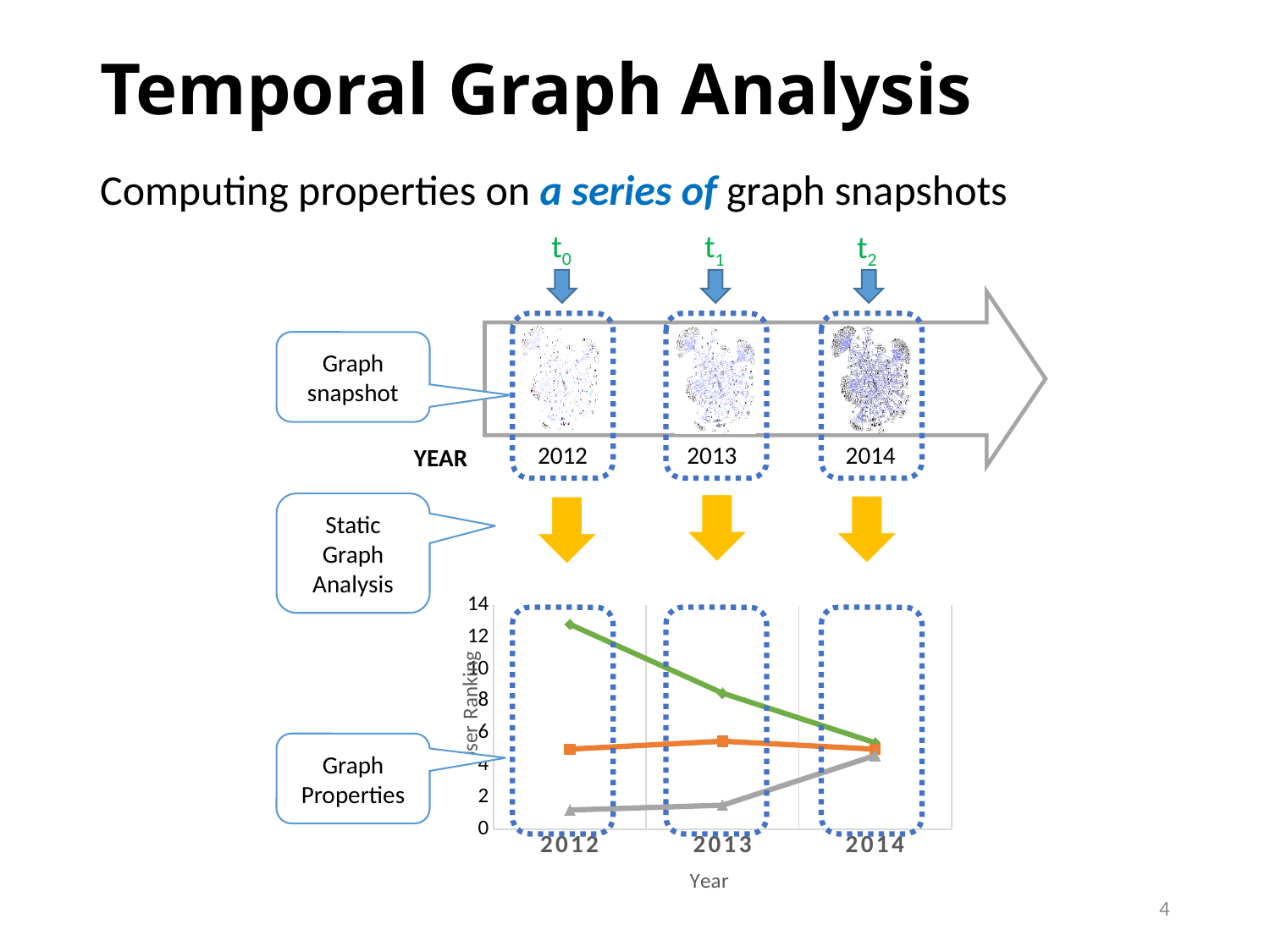
Is the value of the green line in 2013 greater or less than 6? greater What kind of chart is shown at the bottom of the slide? line chart What is the title of the x axis of the line chart? Year In 2012, which line has the larger value, the green line or the orange line? green line Does the gray line rise or fall from 2012 to 2014? rise How many years are shown on the x axis of the line chart? 3 Is the value of the green line in 2012 greater or less than 12? greater Is the value of the gray line in 2014 greater or less than 6? less Does the green line rise or fall from 2012 to 2014? fall How many lines are plotted in the line chart? 3 In 2013, which line has the larger value, the orange line or the gray line? orange line